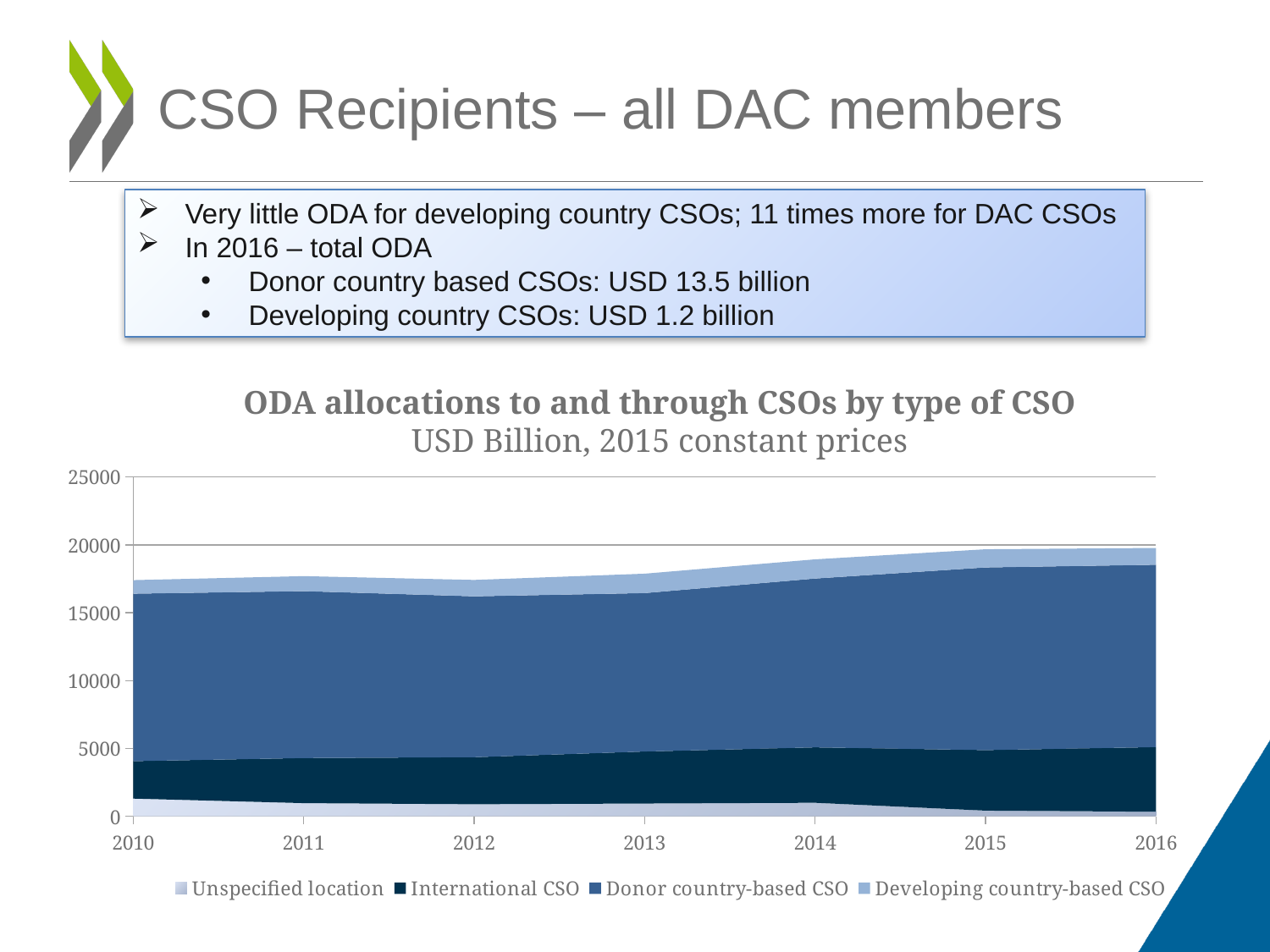
What is the title of the chart? ODA allocations to and through CSOs by type of CSO Is the total ODA to and through CSOs in 2014 greater or less than 20000? less How many series does the chart legend list? 4 Which is larger, the total ODA to and through CSOs in 2016 or in 2010? 2016 Is the total ODA to and through CSOs in 2010 greater or less than 15000? greater Does the total ODA to and through CSOs rise or fall between 2010 and 2016? rise Is the total ODA to and through CSOs in 2016 greater or less than 20000? less What is the last year shown on the x axis of the chart? 2016 What is the first year shown on the x axis of the chart? 2010 Which type of CSO accounts for the largest band in the chart? Donor country-based CSO What kind of chart is shown on the slide? Stacked area chart How many years are shown along the x axis of the chart? 7